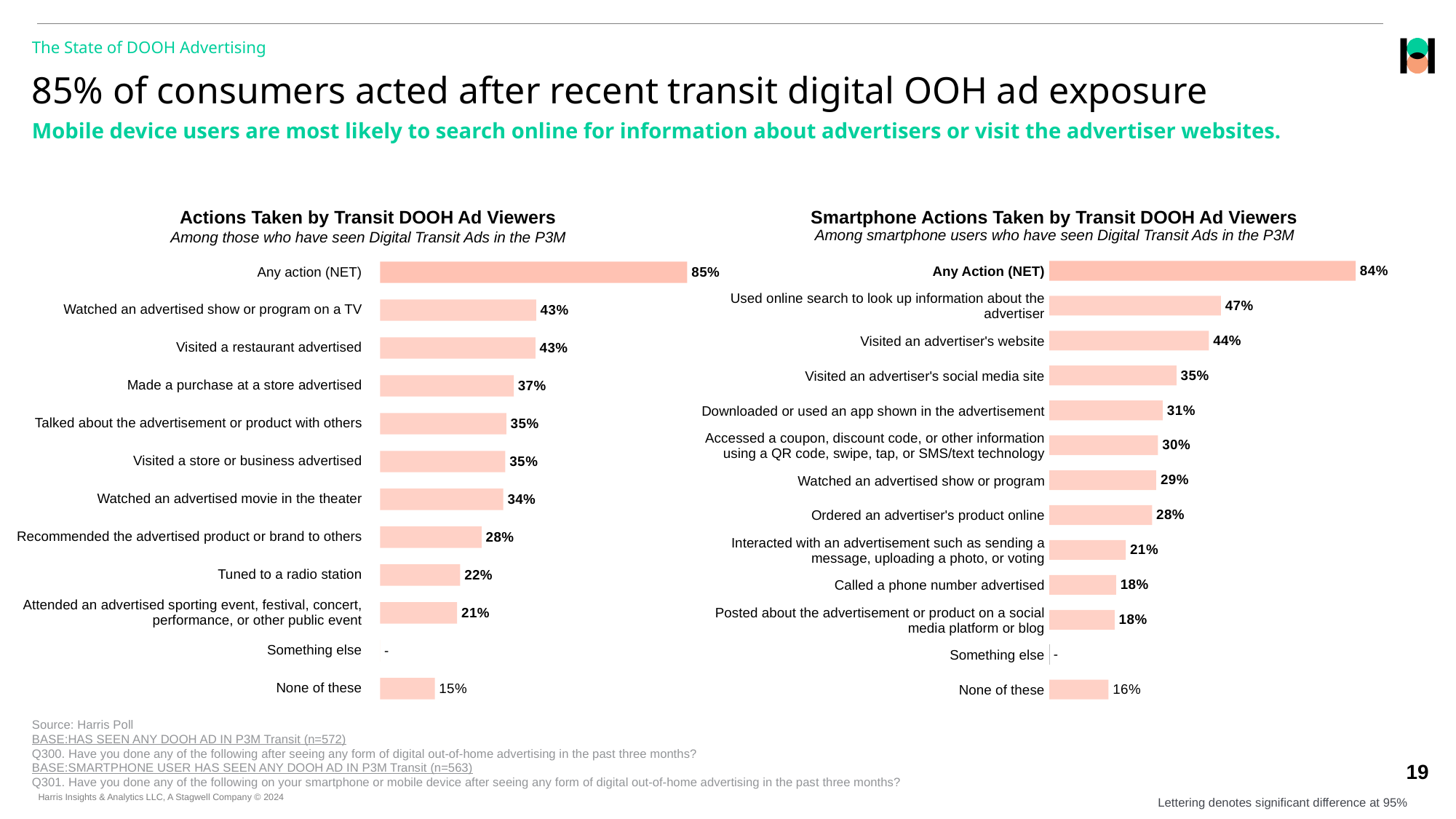
What type of chart is the 'Actions Taken by Transit DOOH Ad Viewers' chart? Bar chart In the 'Smartphone Actions Taken by Transit DOOH Ad Viewers' chart, what is the value for 'None of these'? 16% In the 'Smartphone Actions Taken by Transit DOOH Ad Viewers' chart, what is the value for 'Visited an advertiser's social media site'? 35% In the 'Smartphone Actions Taken by Transit DOOH Ad Viewers' chart, what is the value for 'Called a phone number advertised'? 18% In the 'Actions Taken by Transit DOOH Ad Viewers' chart, what is the value for 'Tuned to a radio station'? 22% In the 'Smartphone Actions Taken by Transit DOOH Ad Viewers' chart, what is the difference between 'Used online search to look up information about the advertiser' and 'Visited an advertiser's website'? 3% In the 'Smartphone Actions Taken by Transit DOOH Ad Viewers' chart, excluding 'Any Action (NET)', which action has the highest value? Used online search to look up information about the advertiser In the 'Actions Taken by Transit DOOH Ad Viewers' chart, which category has the highest value? Any action (NET) In the 'Actions Taken by Transit DOOH Ad Viewers' chart, what is the value for 'Made a purchase at a store advertised'? 37% In the 'Actions Taken by Transit DOOH Ad Viewers' chart, which is larger: 'Watched an advertised movie in the theater' or 'Recommended the advertised product or brand to others'? Watched an advertised movie in the theater In the 'Actions Taken by Transit DOOH Ad Viewers' chart, what is the difference between 'Any action (NET)' and 'None of these'? 70% In the 'Smartphone Actions Taken by Transit DOOH Ad Viewers' chart, which is larger: 'Ordered an advertiser's product online' or 'Downloaded or used an app shown in the advertisement'? Downloaded or used an app shown in the advertisement